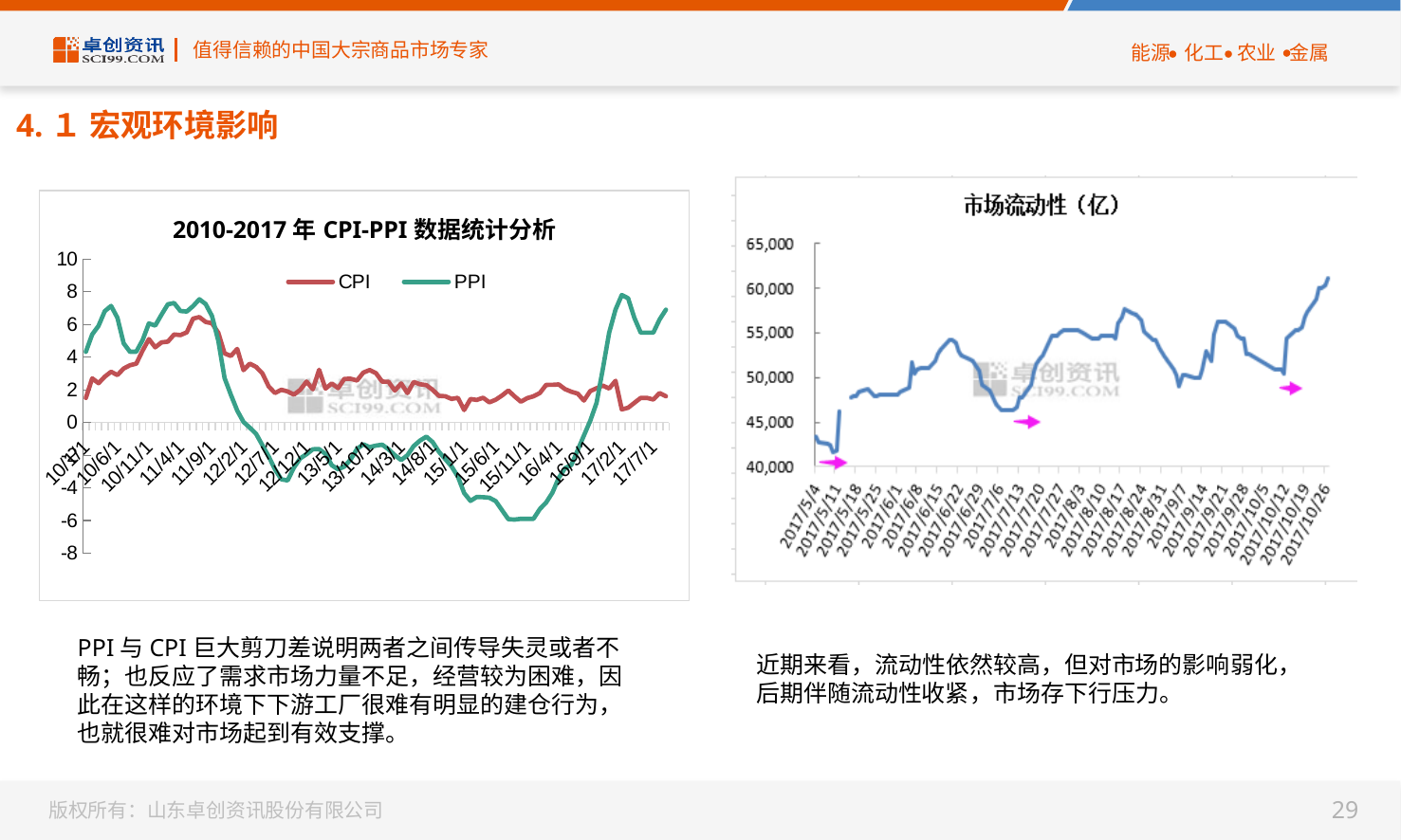
In the '市场流动性（亿）' chart, is the value at 2017/10/26 greater or less than 55,000? greater In the '2010-2017 年 CPI-PPI 数据统计分析' chart, which series is higher at 16/4/1, CPI or PPI? CPI In the '2010-2017 年 CPI-PPI 数据统计分析' chart, is the PPI value at 17/2/1 greater or less than 6? greater In the '2010-2017 年 CPI-PPI 数据统计分析' chart, is the CPI value at 11/9/1 greater or less than 4? greater In the '2010-2017 年 CPI-PPI 数据统计分析' chart, does the PPI line rise or fall between 15/11/1 and 17/2/1? rise In the '2010-2017 年 CPI-PPI 数据统计分析' chart, which series is drawn in green? PPI What kind of chart is the '市场流动性（亿）' chart? line chart In the '市场流动性（亿）' chart, does the line overall rise or fall from 2017/5/4 to 2017/10/26? rise What kind of chart is the '2010-2017 年 CPI-PPI 数据统计分析' chart? line chart How many series does the legend of the '2010-2017 年 CPI-PPI 数据统计分析' chart list? 2